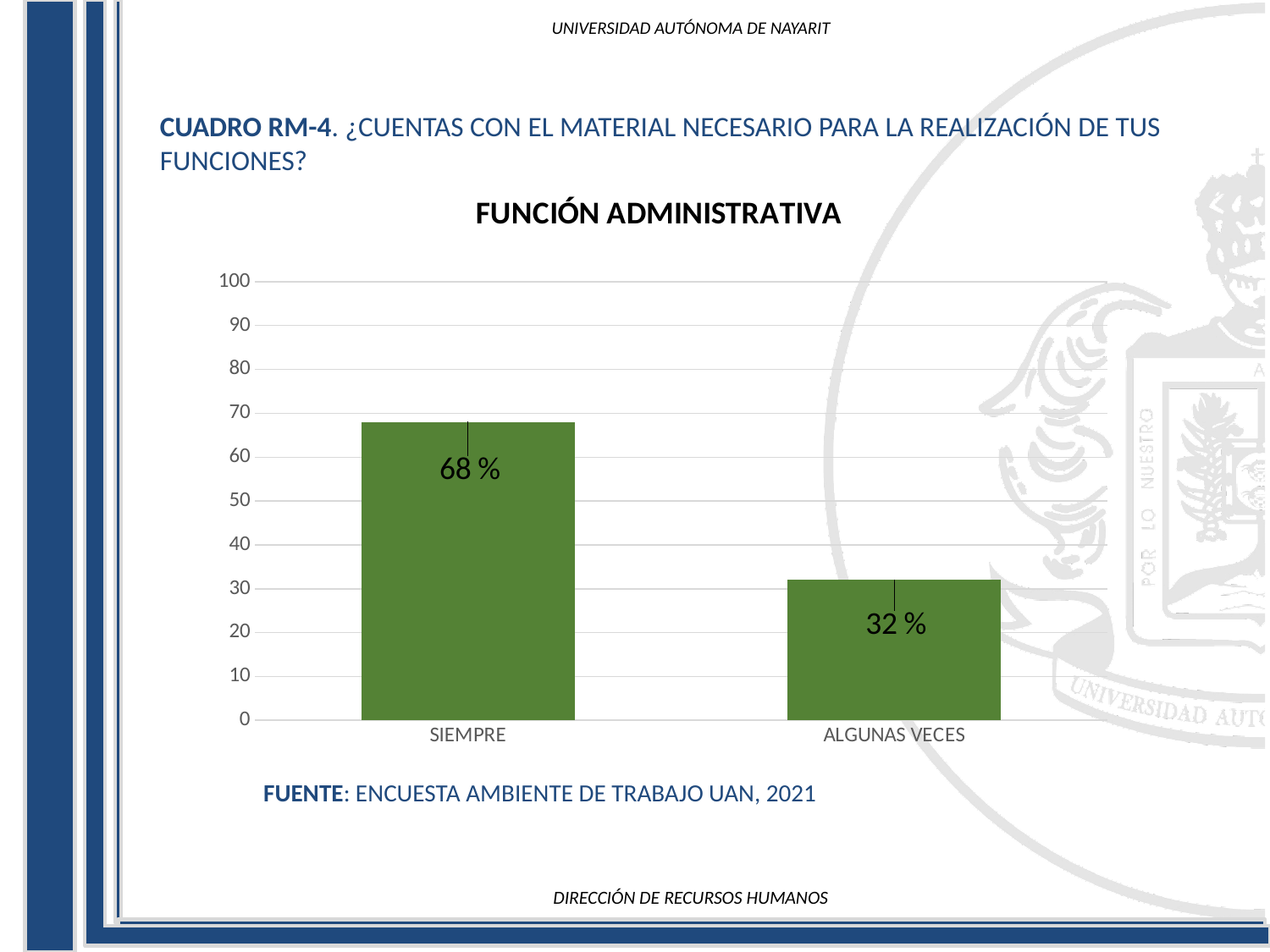
Which category has the lowest value? ALGUNAS VECES What is the value for ALGUNAS VECES? 32 % Is the value for ALGUNAS VECES greater or less than 40? less Which is larger, the value for SIEMPRE or the value for ALGUNAS VECES? SIEMPRE What is the difference between the values for SIEMPRE and ALGUNAS VECES? 36 % What kind of chart is shown on the slide? bar chart What is the value for SIEMPRE? 68 % What colour are the bars in the chart? green How many categories are shown on the x axis? 2 Is the value for SIEMPRE greater or less than 60? greater Which category has the highest value? SIEMPRE What is the title of the chart? FUNCIÓN ADMINISTRATIVA